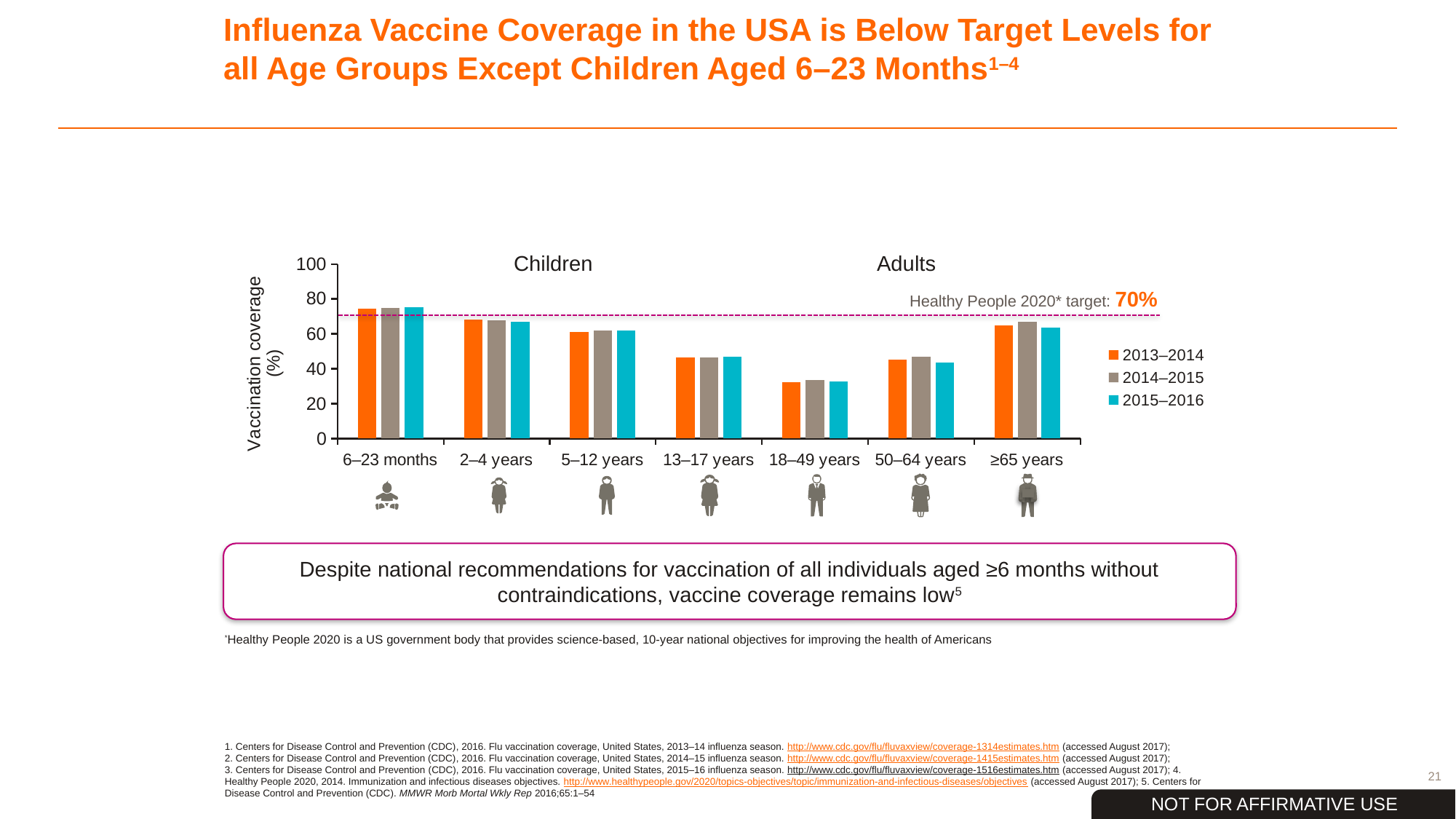
Is the 2014–2015 vaccination coverage for 13–17 years greater or less than 60? less Across the children's age groups from 6–23 months to 13–17 years, does vaccination coverage rise or fall with increasing age? fall Is the 2013–2014 vaccination coverage for 18–49 years greater or less than 40? less How many series does the chart legend list? 3 Which age group has the lowest vaccination coverage in the chart? 18–49 years Which age group has the highest vaccination coverage in the chart? 6–23 months Which has higher 2013–2014 vaccination coverage: 2–4 years or 5–12 years? 2–4 years What is the Healthy People 2020 target shown by the dashed line on the chart? 70% Is the 2013–2014 vaccination coverage for ≥65 years greater or less than 70? less How many age groups are shown on the x axis of the chart? 7 What kind of chart is shown on the slide? bar chart